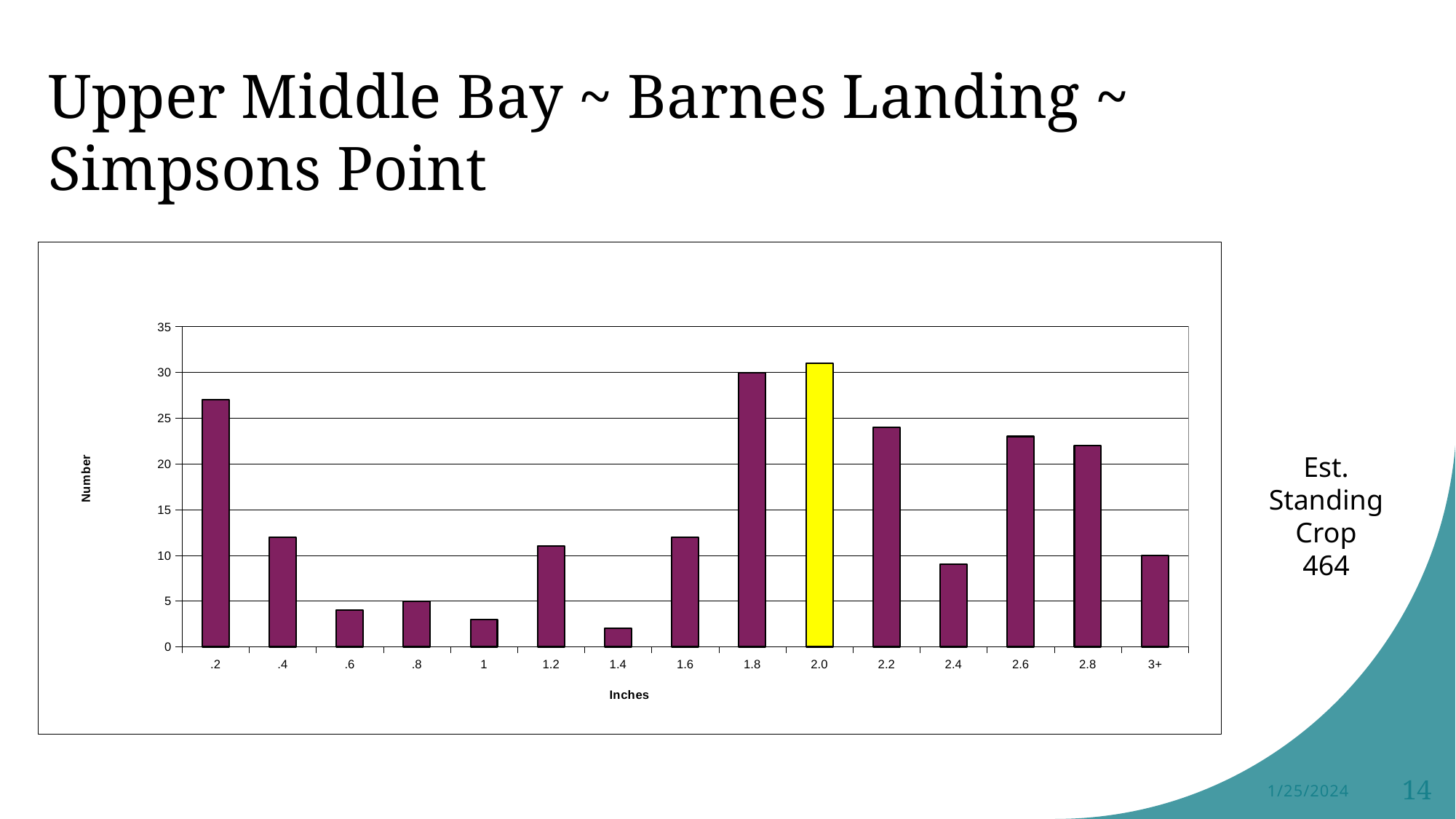
Is the value for 1.4 inches greater or less than 5? less Which has a larger value, .2 inches or .4 inches? .2 Is the value for .2 inches greater or less than 25? greater Is the value for 2.2 inches greater or less than 20? greater Which has a larger value, 2.6 inches or 2.4 inches? 2.6 How many categories are shown on the x axis of the chart? 15 Which category's bar is coloured yellow instead of purple? 2.0 Which has a larger value, 1.6 inches or 1 inch? 1.6 What kind of chart is shown on the slide? bar chart What is the label of the x axis of the chart? Inches